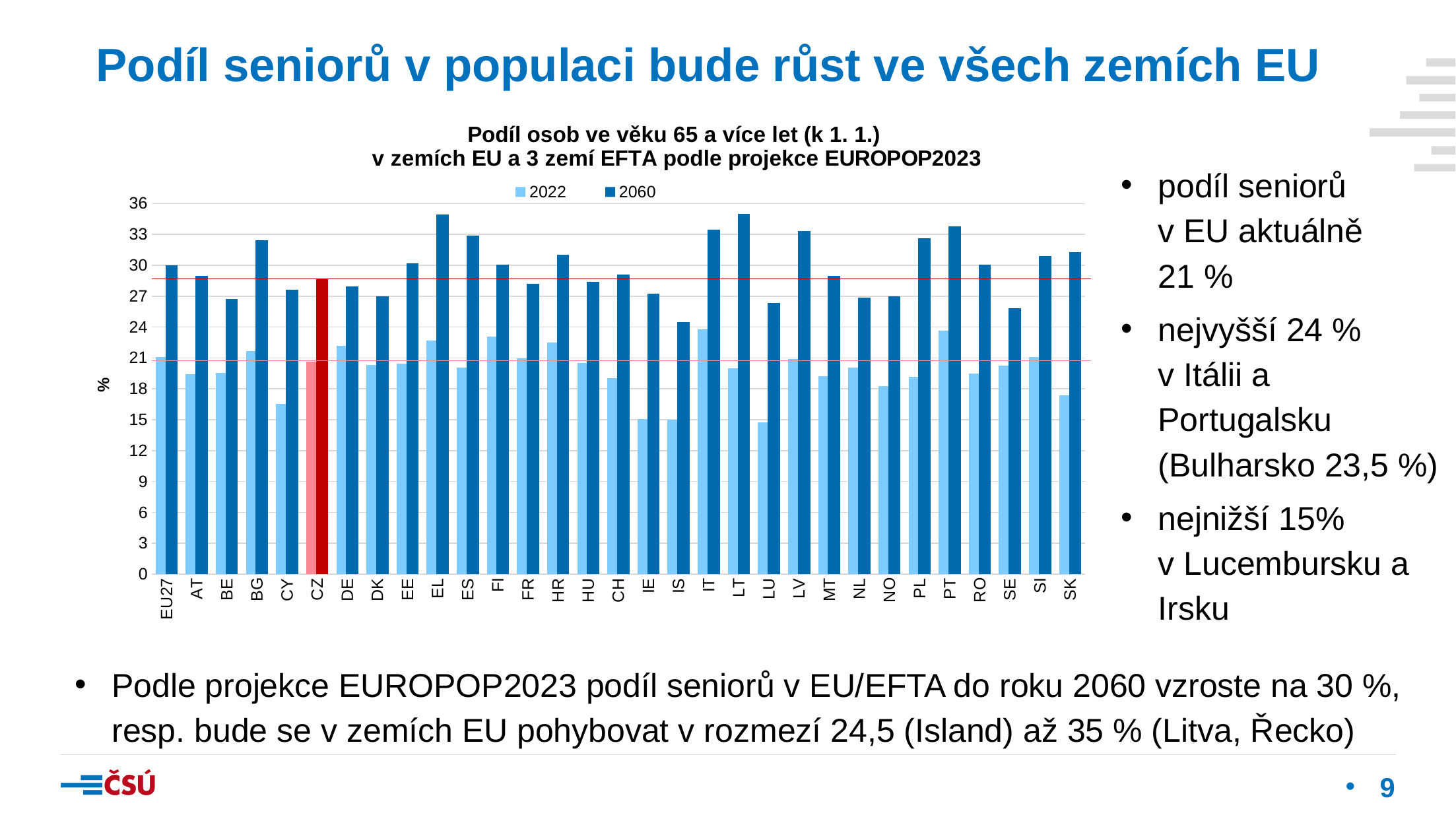
What kind of chart is shown on the slide? bar chart Which category's bars are highlighted in red in the chart? CZ Is the 2022 value for LU greater or less than 18? less Is the 2060 value for EL greater or less than 33? greater Is the 2060 value for BG greater or less than 30? greater Which is larger: the 2022 value for IT or the 2022 value for LU? IT How many countries/categories are shown on the x axis of the chart? 31 Which category has the lowest value in the 2060 series? IS Which is larger: the 2060 value for EL or the 2060 value for BE? EL How many series does the chart legend list? 2